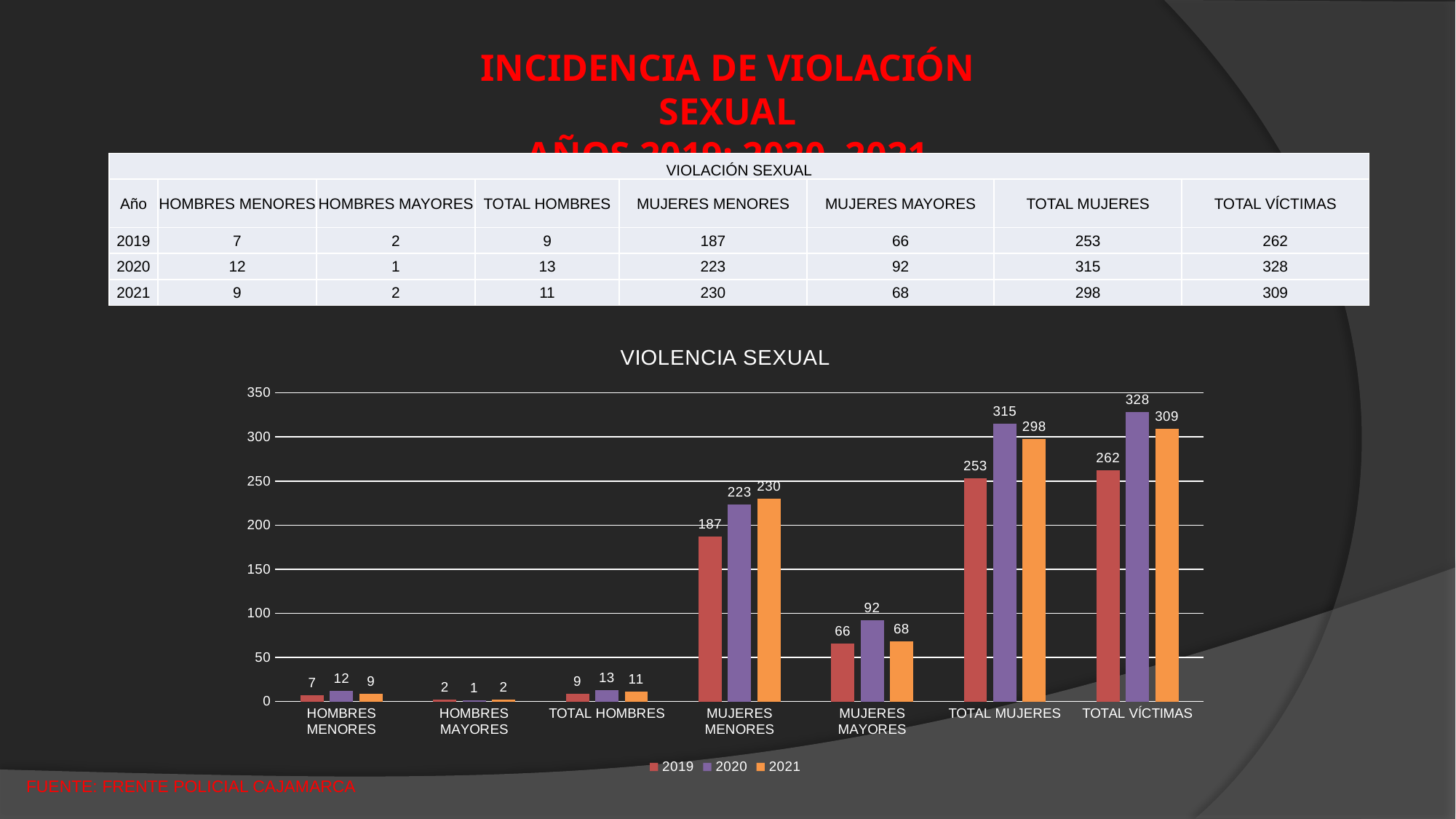
What is the title of the chart? VIOLENCIA SEXUAL What is the difference between the 2020 and 2019 values for TOTAL VÍCTIMAS? 66 How many series does the legend list? 3 Which category has the lowest value for the 2020 series? HOMBRES MAYORES Which year has the highest value for TOTAL MUJERES? 2020 What kind of chart is shown on the slide? bar chart Which is larger: MUJERES MAYORES in 2020 or MUJERES MAYORES in 2021? 2020 Is the value for MUJERES MENORES in 2019 greater or less than 150? greater What is the value for TOTAL VÍCTIMAS in 2019? 262 What is the value for HOMBRES MAYORES in 2021? 2 What is the value for MUJERES MENORES in 2020? 223 How many categories are shown on the x axis of the chart? 7